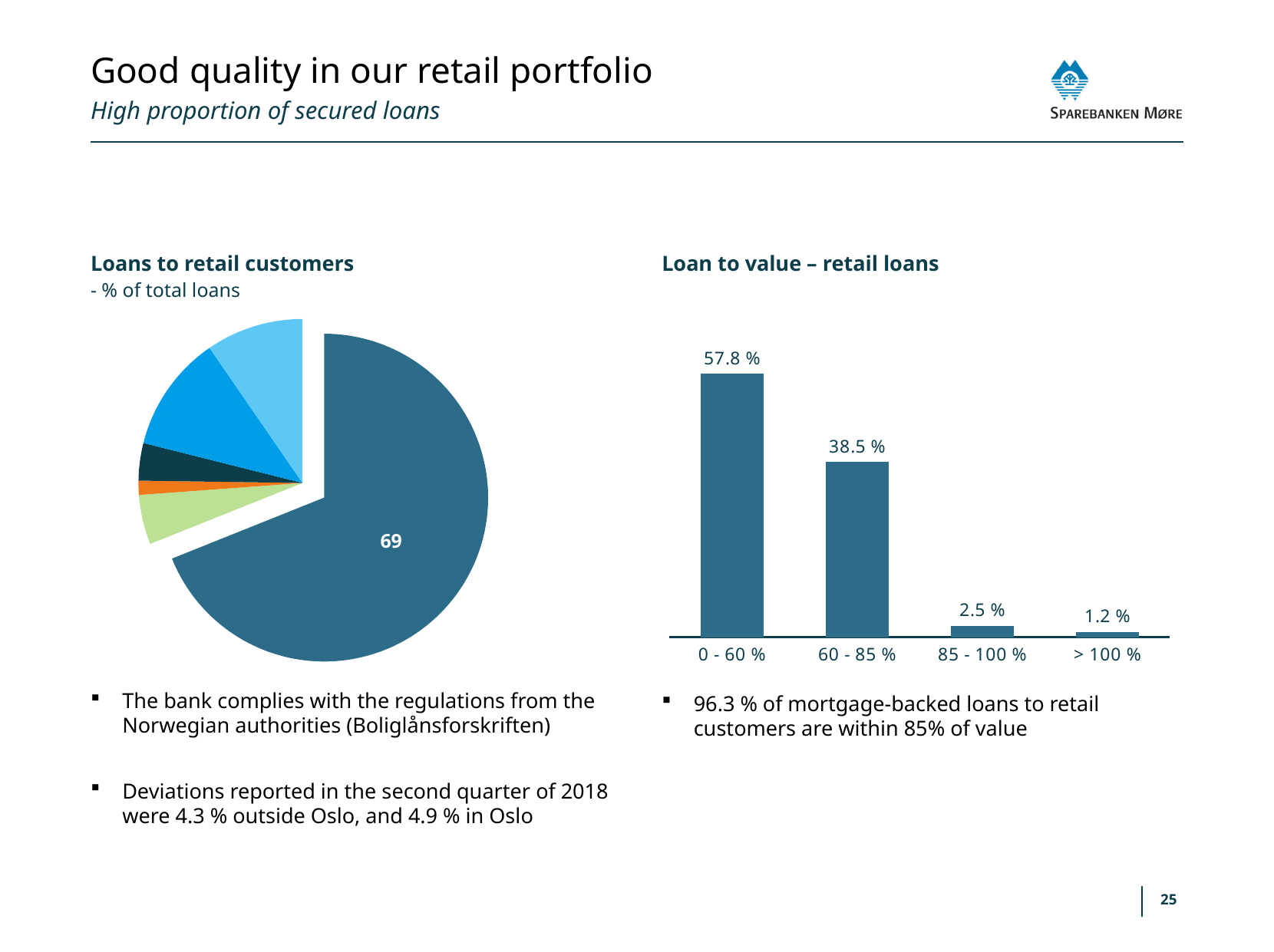
In the 'Loans to retail customers' pie chart, what value is printed on the largest slice? 69 In the 'Loan to value – retail loans' chart, what is the value for the 0 - 60 % category? 57.8 % In the 'Loan to value – retail loans' chart, which is larger: the value for 85 - 100 % or the value for > 100 %? 85 - 100 % In the 'Loan to value – retail loans' chart, what is the difference between the 0 - 60 % and 60 - 85 % values? 19.3 % In the 'Loan to value – retail loans' chart, what is the value for the 85 - 100 % category? 2.5 % In the 'Loan to value – retail loans' chart, do the values rise or fall from left to right along the x axis? Fall In the 'Loan to value – retail loans' chart, what is the value for the 60 - 85 % category? 38.5 % In the 'Loan to value – retail loans' chart, what is the value for the > 100 % category? 1.2 % In the 'Loan to value – retail loans' chart, which category has the lowest value? > 100 % How many categories are shown in the 'Loan to value – retail loans' chart? 4 What kind of chart is the 'Loan to value – retail loans' chart? Bar chart In the 'Loan to value – retail loans' chart, which category has the highest value? 0 - 60 %